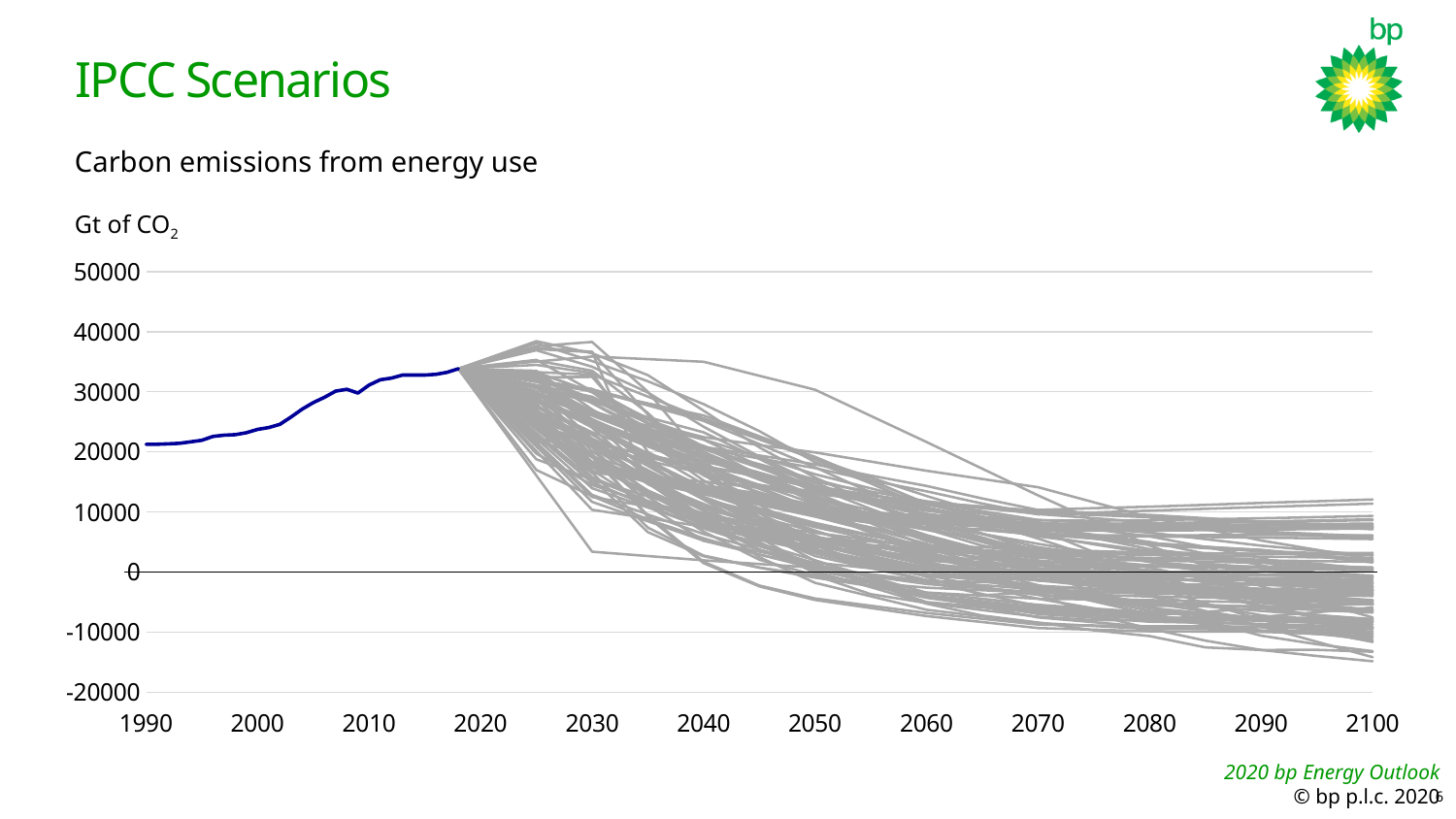
What is the highest value labelled on the y axis? 50000 Is the value of the blue line in 2010 greater or less than 40000? less What unit is shown on the chart's y axis? Gt of CO2 Does the blue historical line rise or fall between 1990 and 2020? rise How many year labels are shown on the x axis? 12 Is the value of the blue line in 2000 greater or less than 30000? less What kind of chart is shown on the slide? line chart What is the title of the chart? Carbon emissions from energy use Is the value of the blue line in 1990 greater or less than 30000? less